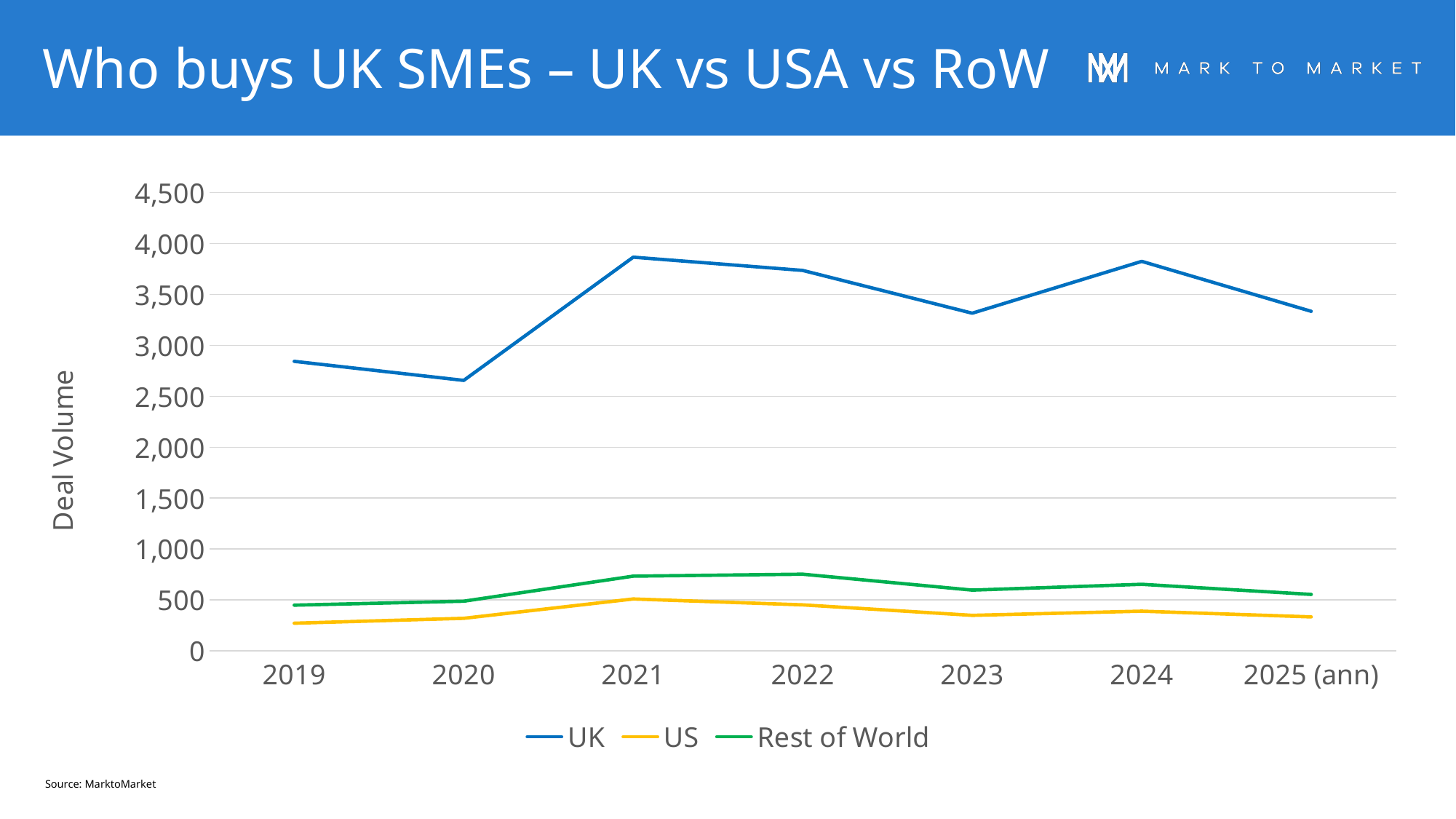
What kind of chart is shown on the slide? Line chart In which year is the US series at its highest? 2021 Which series has the larger value in 2023, UK or Rest of World? UK In which year is the UK series at its lowest? 2020 Is the UK value for 2019 greater or less than 3,000? less How many series does the legend list? 3 Is the UK value for 2021 greater or less than 3,500? greater Is the Rest of World value for 2022 greater or less than 500? greater How many years (points) are shown along the x axis? 7 In which year is the US series at its lowest? 2019 What is the label on the vertical axis? Deal Volume Does the UK series rise or fall from 2019 to 2020? Fall